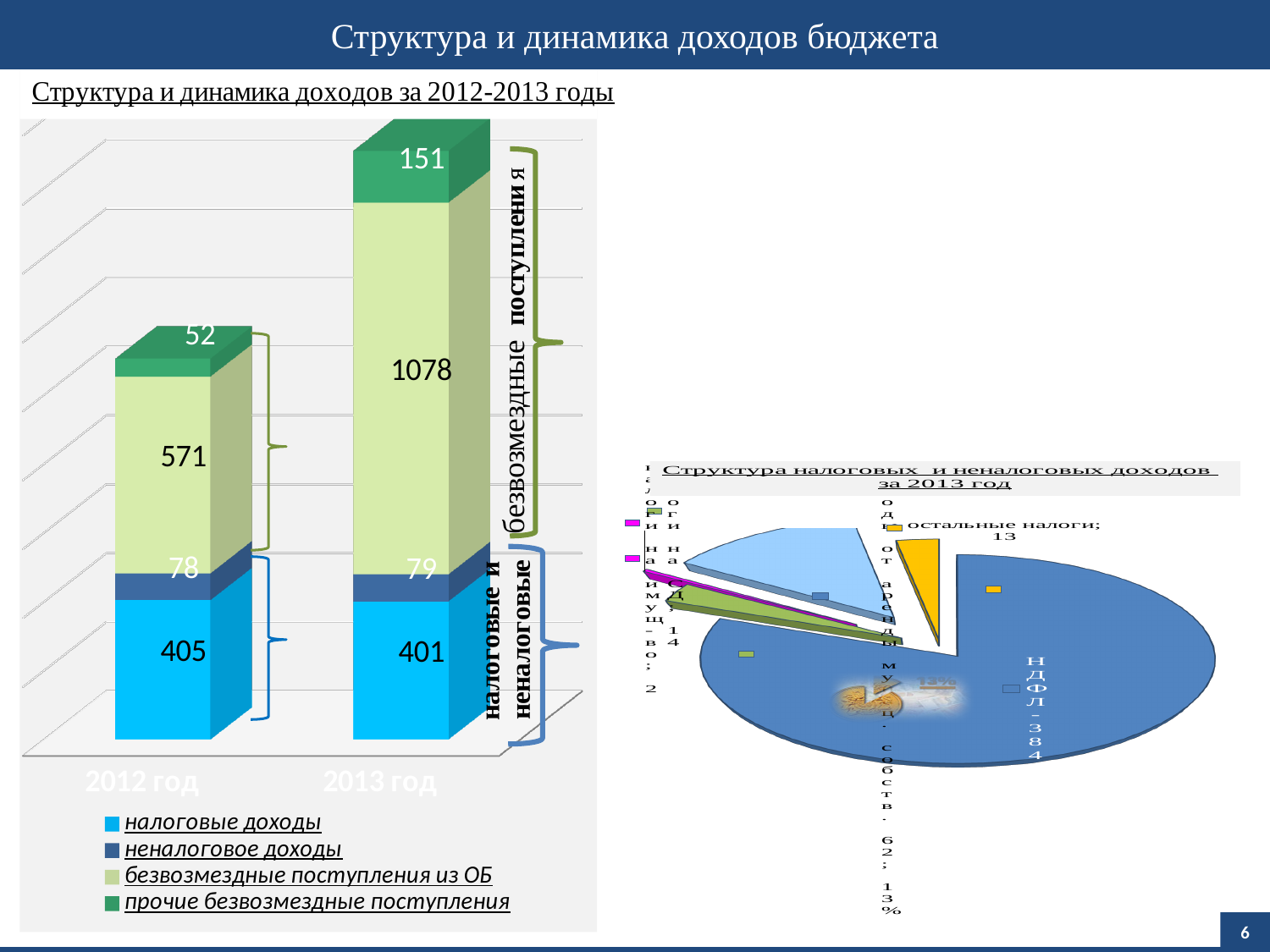
In the left bar chart, what is the total of the stacked bar for 2012 год? 1106 In the left bar chart, which year has the larger value for налоговые доходы, 2012 год or 2013 год? 2012 год In the left bar chart, what is the value of налоговые доходы for 2012 год? 405 What kind of chart is the chart on the left of the slide? stacked bar chart In the left bar chart, what is the value of неналоговое доходы for 2012 год? 78 In the pie chart titled 'Структура налоговых и неналоговых доходов за 2013 год', what value is shown for остальные налоги? 13 In the left bar chart, what is the difference in прочие безвозмездные поступления between 2013 год and 2012 год? 99 In the left bar chart, what is the value of прочие безвозмездные поступления for 2013 год? 151 How many series does the legend of the left bar chart list? 4 In the left bar chart, by how much did безвозмездные поступления из ОБ increase from 2012 год to 2013 год? 507 In the left bar chart, what is the value of безвозмездные поступления из ОБ for 2013 год? 1078 In the left bar chart, what is the total of the stacked bar for 2013 год? 1709